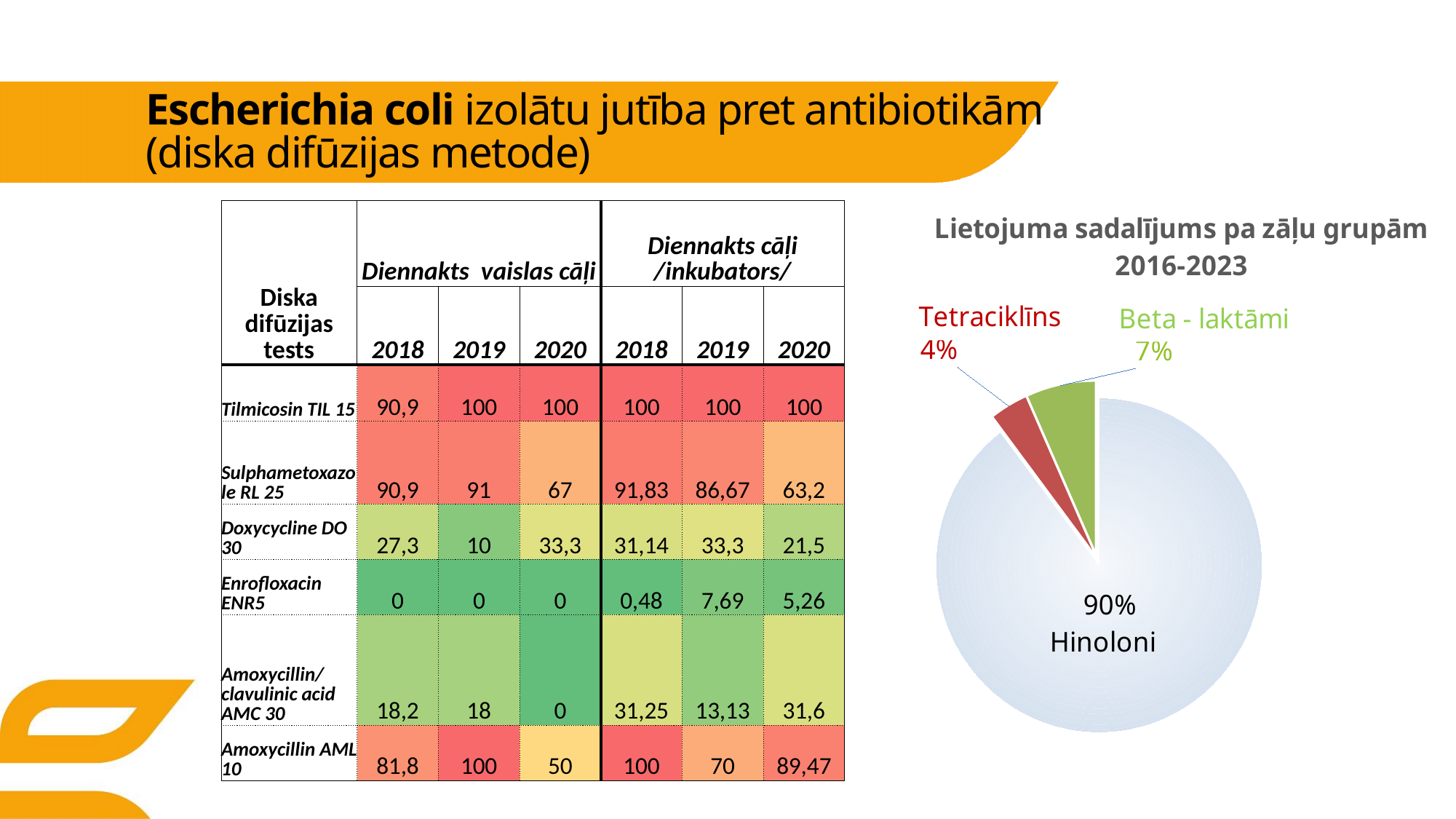
In the pie chart, how many percentage points larger is Hinoloni than Beta - laktāmi? 83 percentage points In the pie chart, which is larger: Beta - laktāmi or Tetraciklīns? Beta - laktāmi Which drug group has the largest slice in the pie chart? Hinoloni What colour is the Tetraciklīns slice in the pie chart? red How many slices does the pie chart have? 3 What kind of chart is shown on the right side of the slide? pie chart What is the title of the pie chart? Lietojuma sadalījums pa zāļu grupām 2016-2023 In the pie chart, what is the difference between the Beta - laktāmi share and the Tetraciklīns share? 3 percentage points In the pie chart, what share does Tetraciklīns have? 4% In the pie chart, what share does Beta - laktāmi have? 7% Which drug group has the smallest slice in the pie chart? Tetraciklīns In the pie chart 'Lietojuma sadalījums pa zāļu grupām 2016-2023', what share does Hinoloni have? 90%